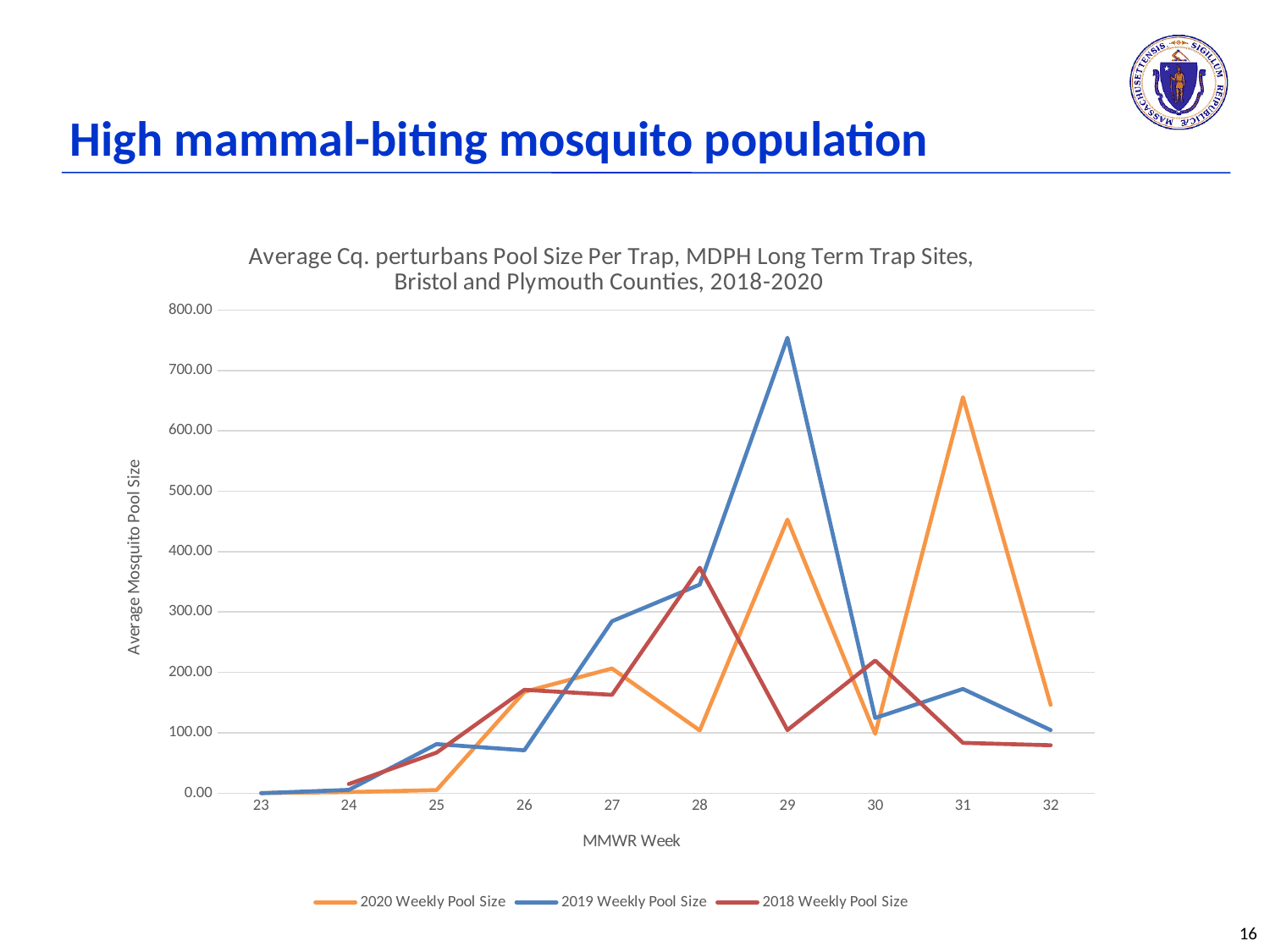
At week 29, which series has the larger value: 2019 Weekly Pool Size or 2020 Weekly Pool Size? 2019 Weekly Pool Size Is the 2019 Weekly Pool Size value for week 29 greater or less than 700? greater How many series does the legend list? 3 In which MMWR week does the 2019 Weekly Pool Size reach its highest value? 29 Is the 2018 Weekly Pool Size value for week 28 greater or less than 300? greater What is the label on the y axis of the chart? Average Mosquito Pool Size Is the 2018 Weekly Pool Size value for week 30 greater or less than 300? less How many MMWR weeks are plotted along the x axis? 10 In which MMWR week does the 2020 Weekly Pool Size reach its highest value? 31 What kind of chart is shown on the slide? Line chart Does the 2019 Weekly Pool Size rise or fall from week 29 to week 32? Fall